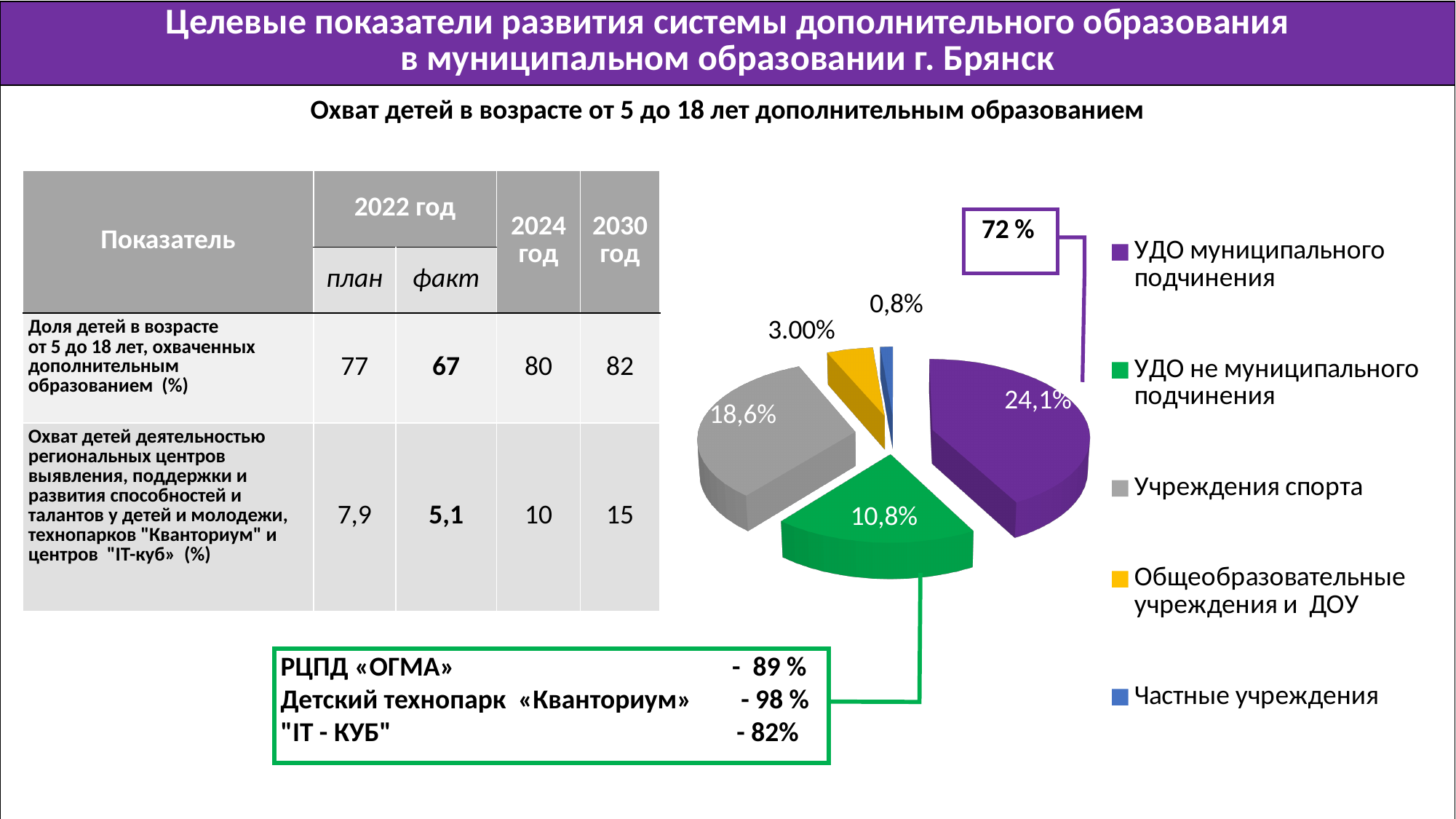
How many slices does the pie chart have? 5 Which category has the smallest slice in the pie chart? Частные учреждения How many entries does the legend of the pie chart list? 5 What value is shown for the slice 'Учреждения спорта'? 18,6% What value is shown for the slice 'УДО не муниципального подчинения'? 10,8% What value is shown for the slice 'Общеобразовательные учреждения и ДОУ'? 3.00% Which category has the largest slice in the pie chart? УДО муниципального подчинения What value is shown for the slice 'Частные учреждения'? 0,8% What is the difference between the values for 'УДО муниципального подчинения' and 'Учреждения спорта'? 5,5% What value is shown for the slice 'УДО муниципального подчинения'? 24,1% What kind of chart is shown on the slide? pie chart Which is larger: the slice for 'Учреждения спорта' or the slice for 'УДО не муниципального подчинения'? Учреждения спорта